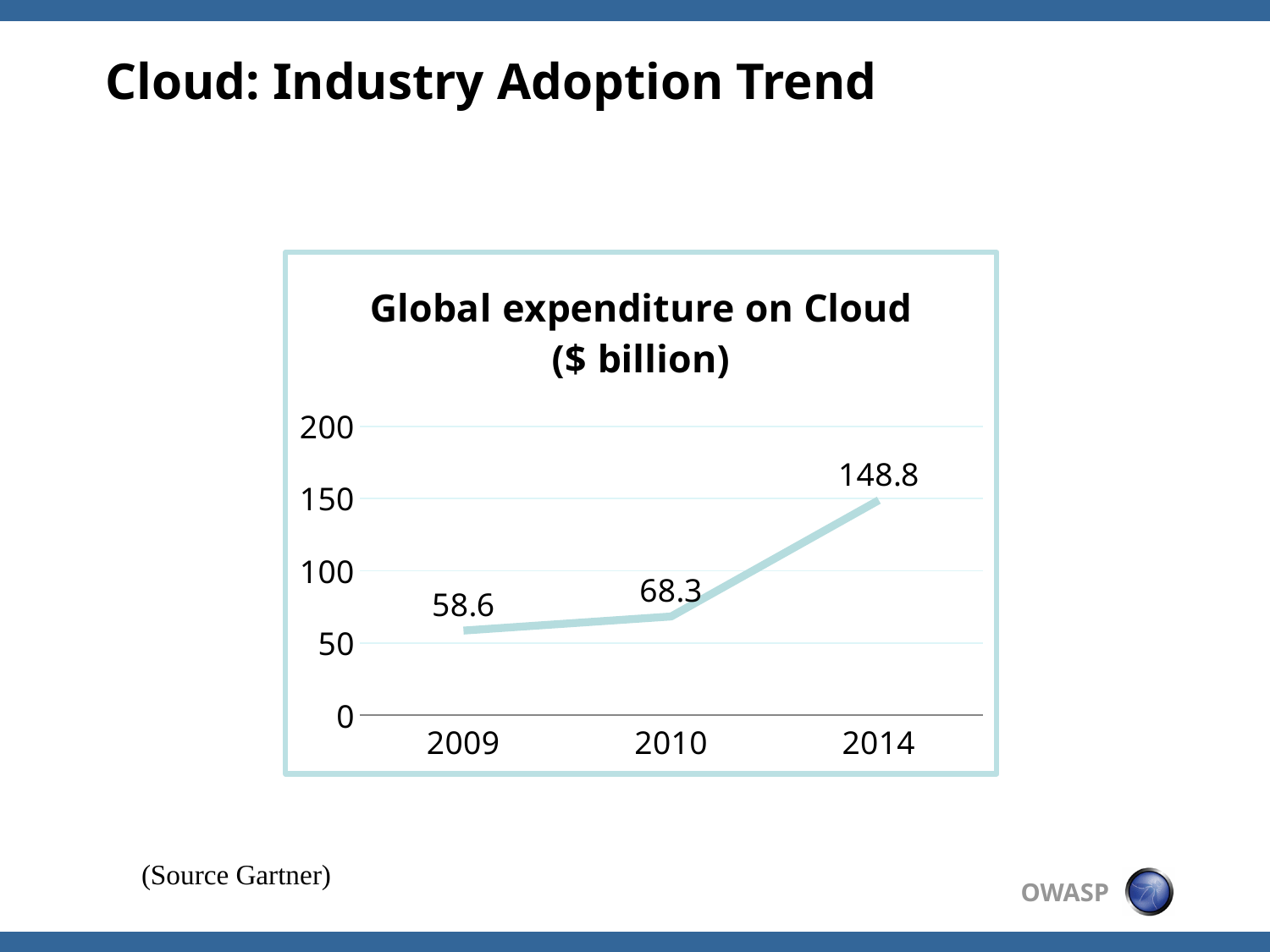
What is the global expenditure on Cloud for 2014? 148.8 Is the value for 2014 greater or less than 100? greater Which year has the highest global expenditure on Cloud? 2014 Which is larger, the value for 2010 or the value for 2014? 2014 What is the global expenditure on Cloud for 2009? 58.6 How many years are plotted on the chart? 3 Which year has the lowest global expenditure on Cloud? 2009 What kind of chart is shown on the slide? line chart What is the difference between the 2014 and 2009 values? 90.2 What is the global expenditure on Cloud for 2010? 68.3 Do the values rise or fall from 2009 to 2014? rise What is the difference between the 2010 and 2009 values? 9.7